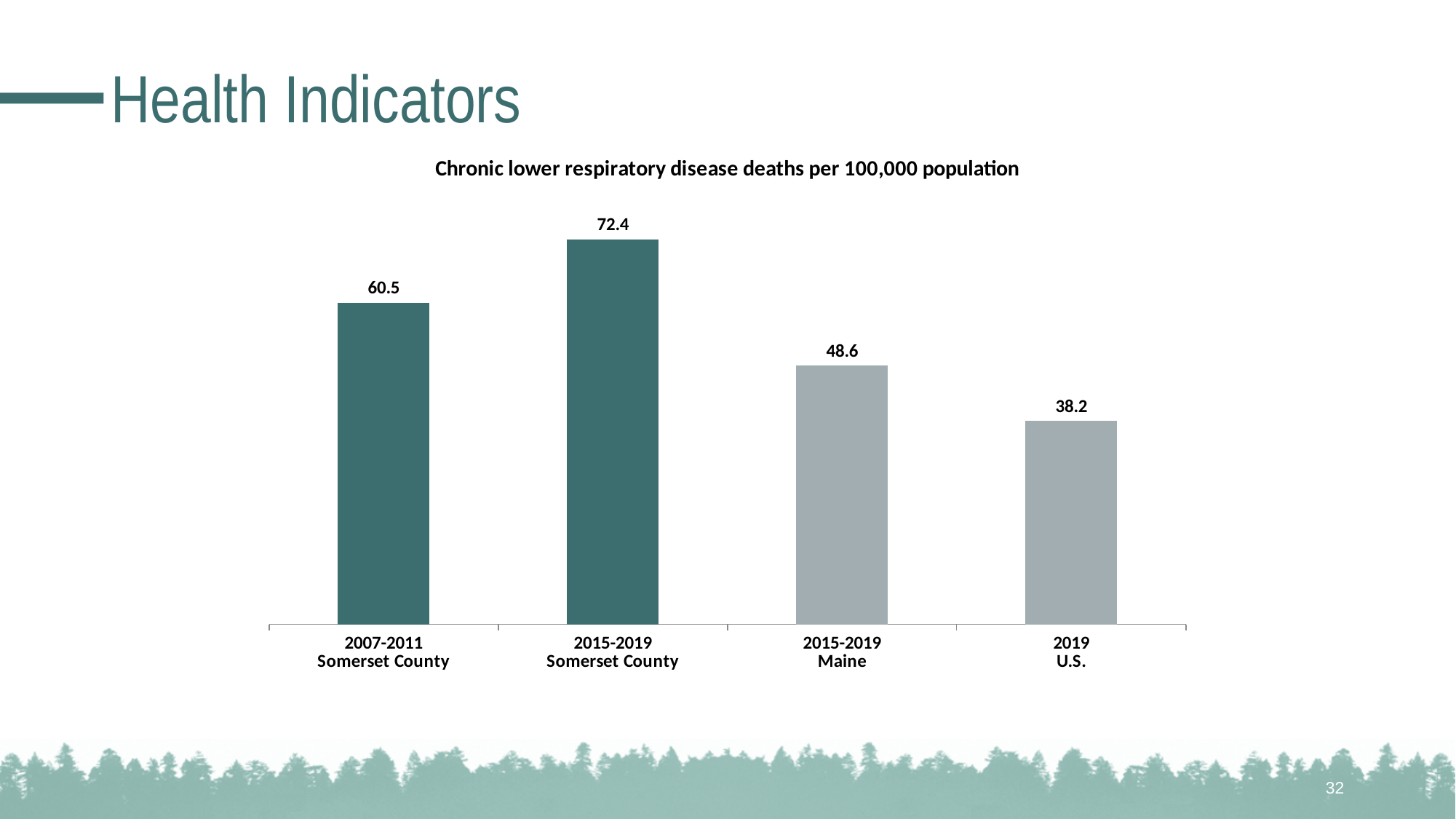
What is the difference between the 2015-2019 Somerset County value and the 2007-2011 Somerset County value? 11.9 Which is larger, the value for 2015-2019 Maine or the value for 2019 U.S.? 2015-2019 Maine What kind of chart is shown on the slide? Bar chart What is the value for 2007-2011 Somerset County? 60.5 How many bars are shown in the chart? 4 Which category has the highest value? 2015-2019 Somerset County Which category has the lowest value? 2019 U.S. What is the difference between the 2015-2019 Somerset County value and the 2015-2019 Maine value? 23.8 What is the value for 2015-2019 Maine? 48.6 What is the value for 2019 U.S.? 38.2 What is the title of the chart? Chronic lower respiratory disease deaths per 100,000 population What is the value for 2015-2019 Somerset County? 72.4